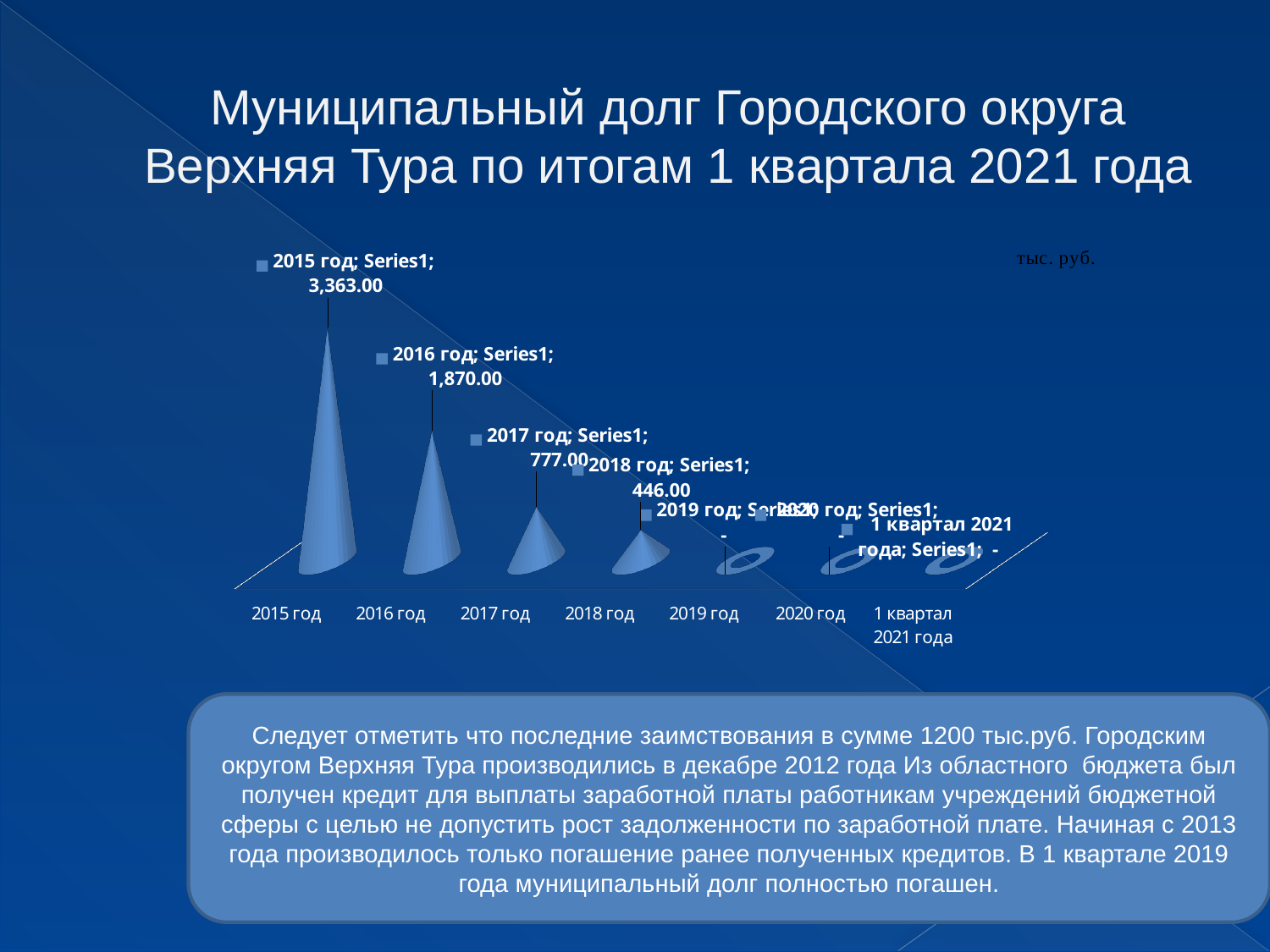
What is the data label shown for 2019 год? - Do the values rise or fall from 2015 год to 2018 год? fall What is the value shown for 2017 год? 777.00 Which year has the highest municipal debt on the chart? 2015 год What is the value shown for 2018 год? 446.00 Which is larger, the value for 2016 год or the value for 2017 год? 2016 год What is the difference between the values for 2017 год and 2018 год? 331.00 What is the value shown for 2016 год? 1,870.00 What is the difference between the values for 2015 год and 2016 год? 1,493.00 What is the municipal debt value shown for 2015 год? 3,363.00 What kind of chart is shown on the slide? bar chart How many categories are shown on the x axis of the chart? 7